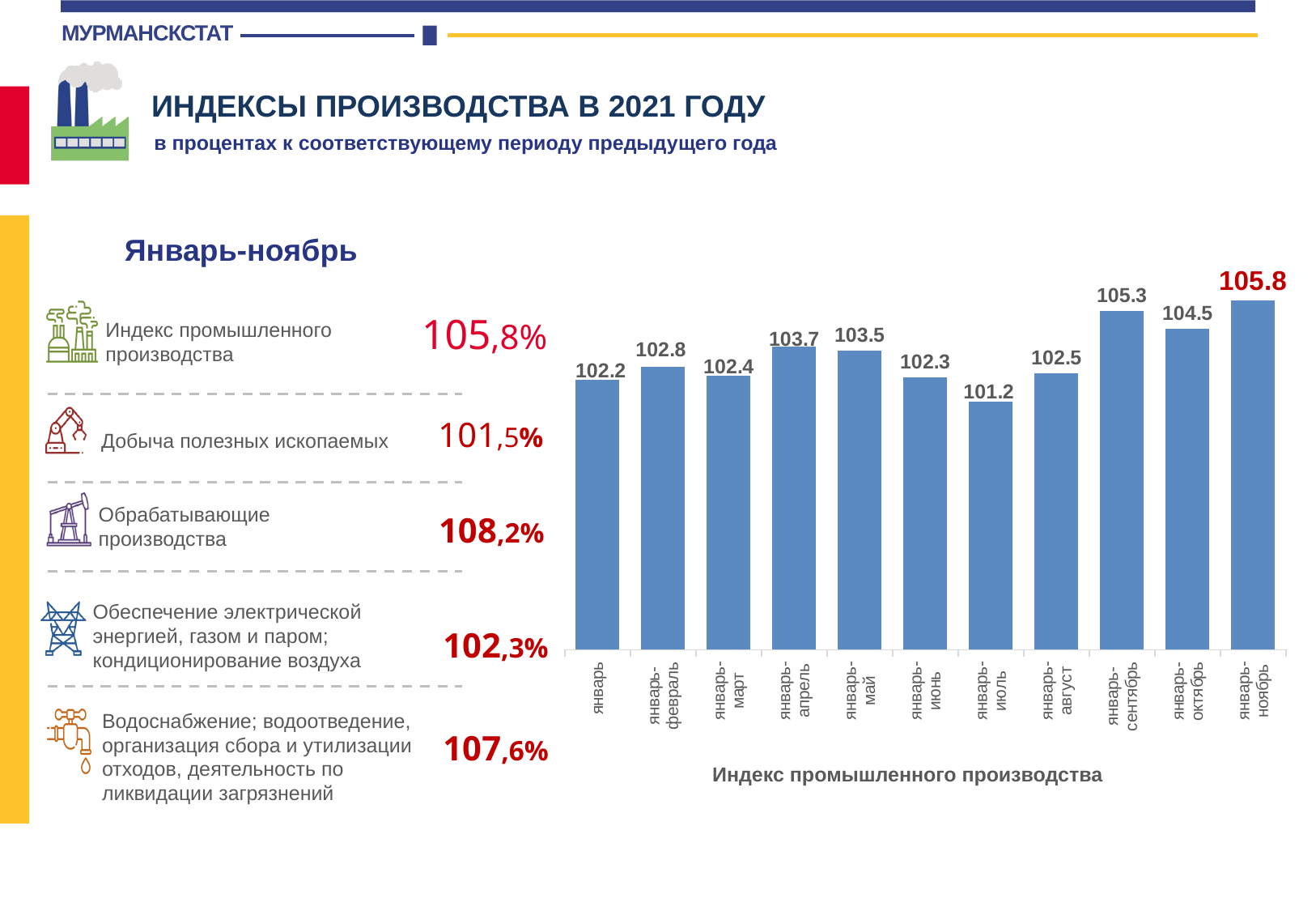
Which period has the lowest value in the chart? январь-июль What is the value for январь-июль in the chart? 101.2 What kind of chart is shown on the slide? bar chart What is the value for январь-апрель in the chart? 103.7 What is the value for январь-ноябрь in the chart? 105.8 What is the difference between the values for январь-сентябрь and январь-октябрь? 0.8 Do the values rise or fall from январь-август to январь-сентябрь? rise How many bars are plotted in the chart? 11 Which is larger: the value for январь-май or the value for январь-июнь? январь-май Which period has the highest value in the chart? январь-ноябрь What is the difference between the values for январь-ноябрь and январь? 3.6 What is the name of the series shown below the chart? Индекс промышленного производства